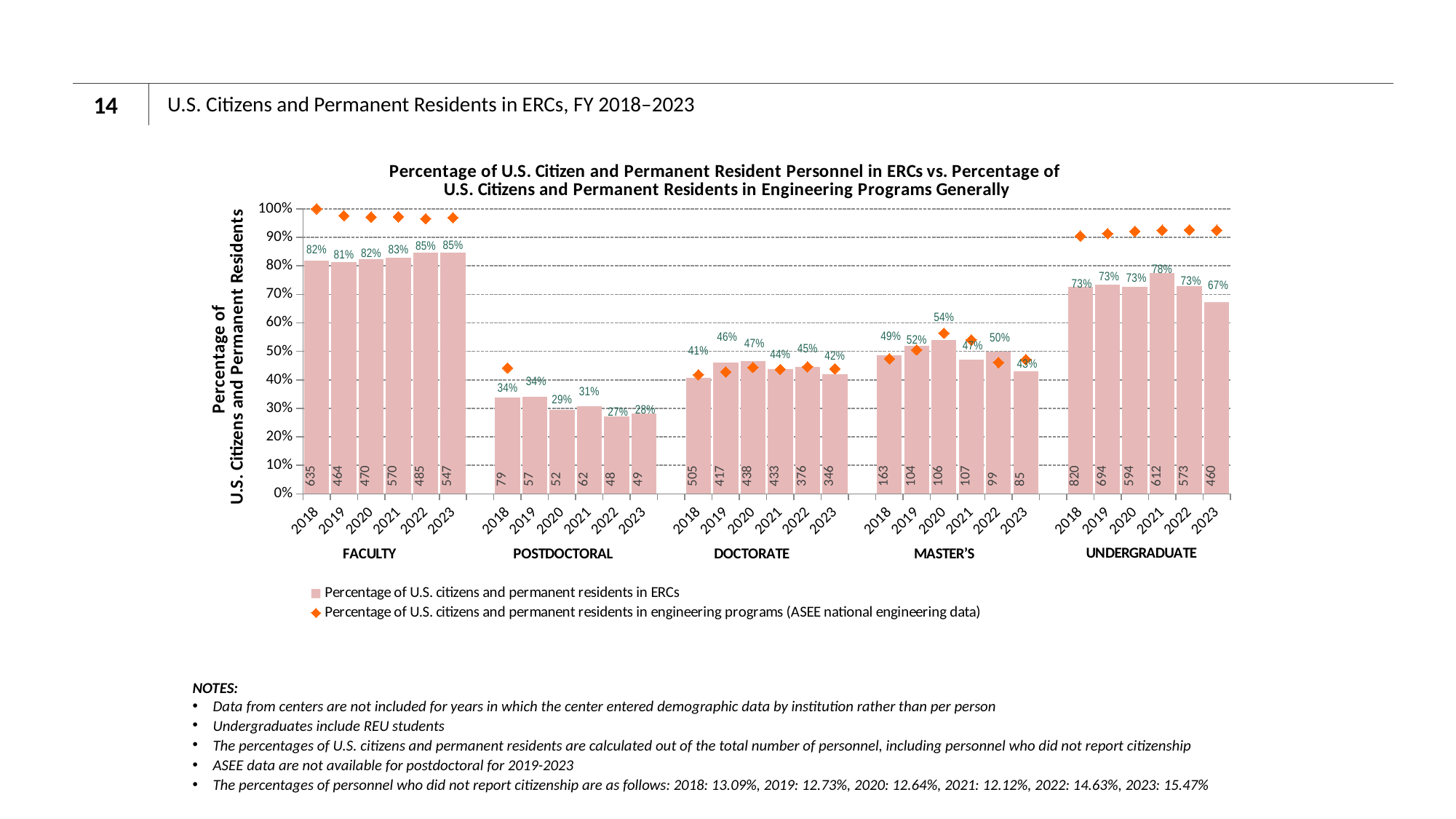
Which year has the highest percentage of U.S. citizens and permanent residents in ERCs among the Master's bars? 2020 What is the difference in percentage points between the Undergraduate ERC percentage in 2021 and in 2023? 11 What is the count label printed inside the Undergraduate bar for 2018? 820 What percentage of U.S. citizens and permanent residents in ERCs is shown for Faculty in 2022? 85% Is the ASEE national engineering data value (orange diamond) for Undergraduate in 2021 greater or less than 80%? greater How many series does the legend list? 2 Which is larger: the Doctorate ERC percentage in 2020 or the Master's ERC percentage in 2023? Doctorate 2020 Do the Faculty ERC percentages generally rise or fall from 2019 to 2023? rise Which year has the lowest percentage of U.S. citizens and permanent residents in ERCs among the Postdoctoral bars? 2022 How many personnel categories (groups of bars) are shown on the x axis? 5 Is the ASEE national engineering data value (orange diamond) for Doctorate in 2019 greater or less than 50%? less What percentage of U.S. citizens and permanent residents in ERCs is shown for Postdoctoral in 2020? 29%